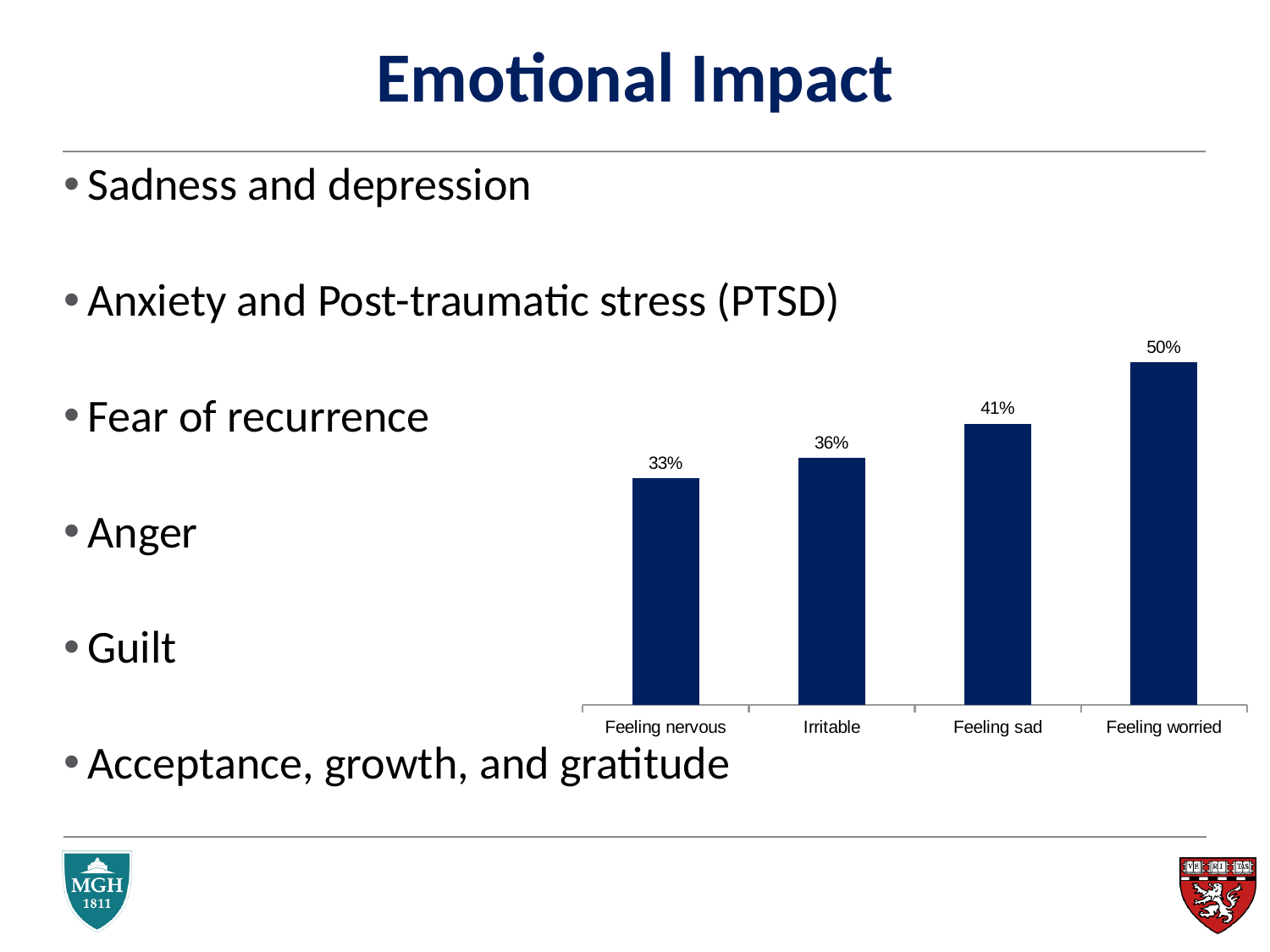
What is the value for Feeling nervous? 33% What is the value for Irritable? 36% Which is larger, the value for Feeling sad or the value for Irritable? Feeling sad What is the difference between the values for Feeling worried and Feeling nervous? 17% How many categories are shown in the chart? 4 Do the values rise or fall from left to right along the x axis? Rise What is the value for Feeling worried? 50% What kind of chart is shown on the slide? Bar chart What is the difference between the values for Feeling sad and Irritable? 5% Which category has the lowest value? Feeling nervous What is the value for Feeling sad? 41% Which category has the highest value? Feeling worried